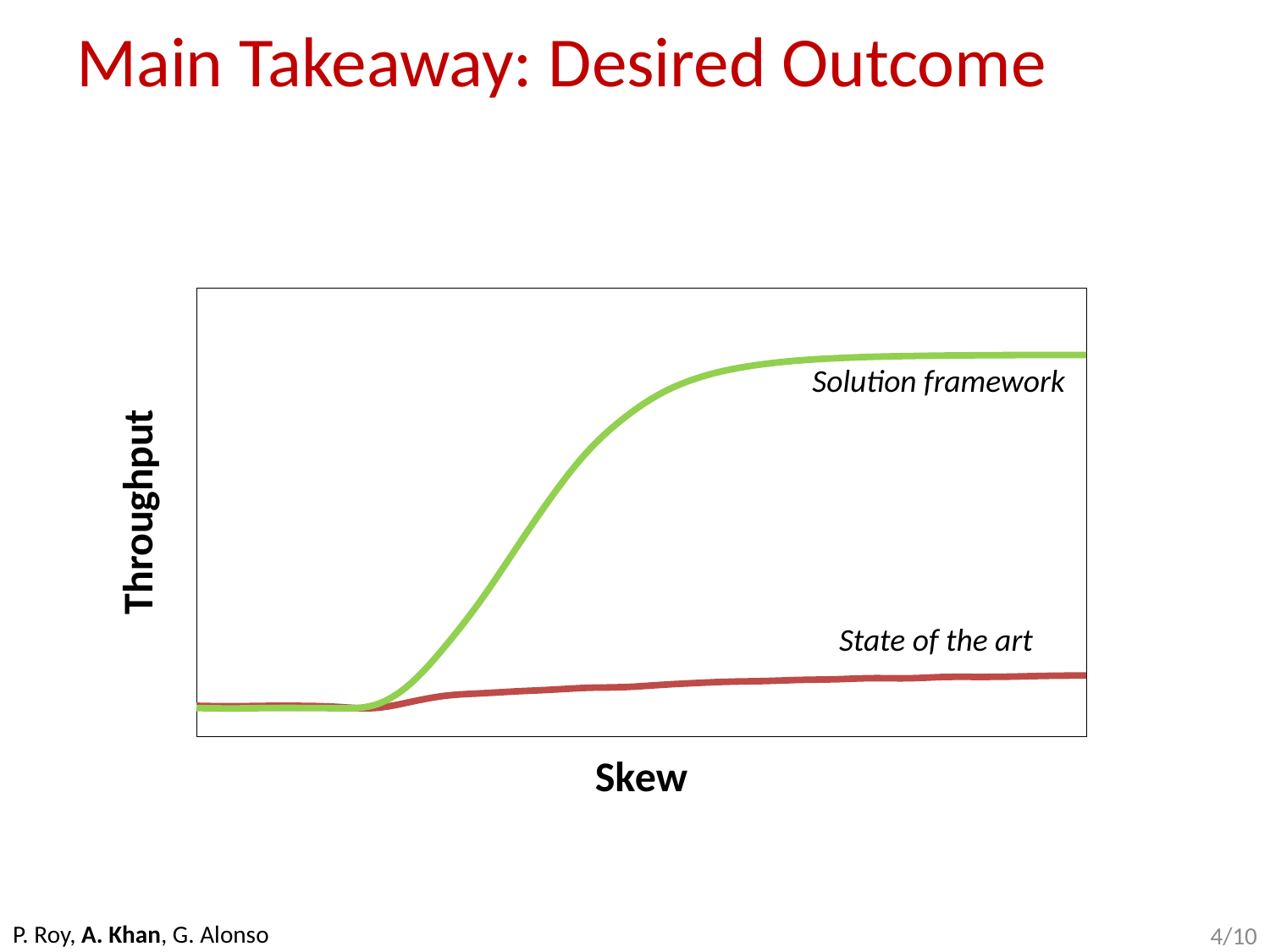
What kind of chart is shown on the slide? line chart How many series are plotted on the chart? 2 What are the names of the two series plotted on the chart? Solution framework and State of the art What is the label of the y axis? Throughput Which series reaches the highest Throughput on the chart? Solution framework What is the label of the x axis? Skew Which series shows the steeper increase in Throughput as Skew grows? Solution framework Does the Solution framework line rise or fall as Skew increases? rise Does the State of the art line rise or fall as Skew increases? rise At high Skew, which series has the higher Throughput: Solution framework or State of the art? Solution framework